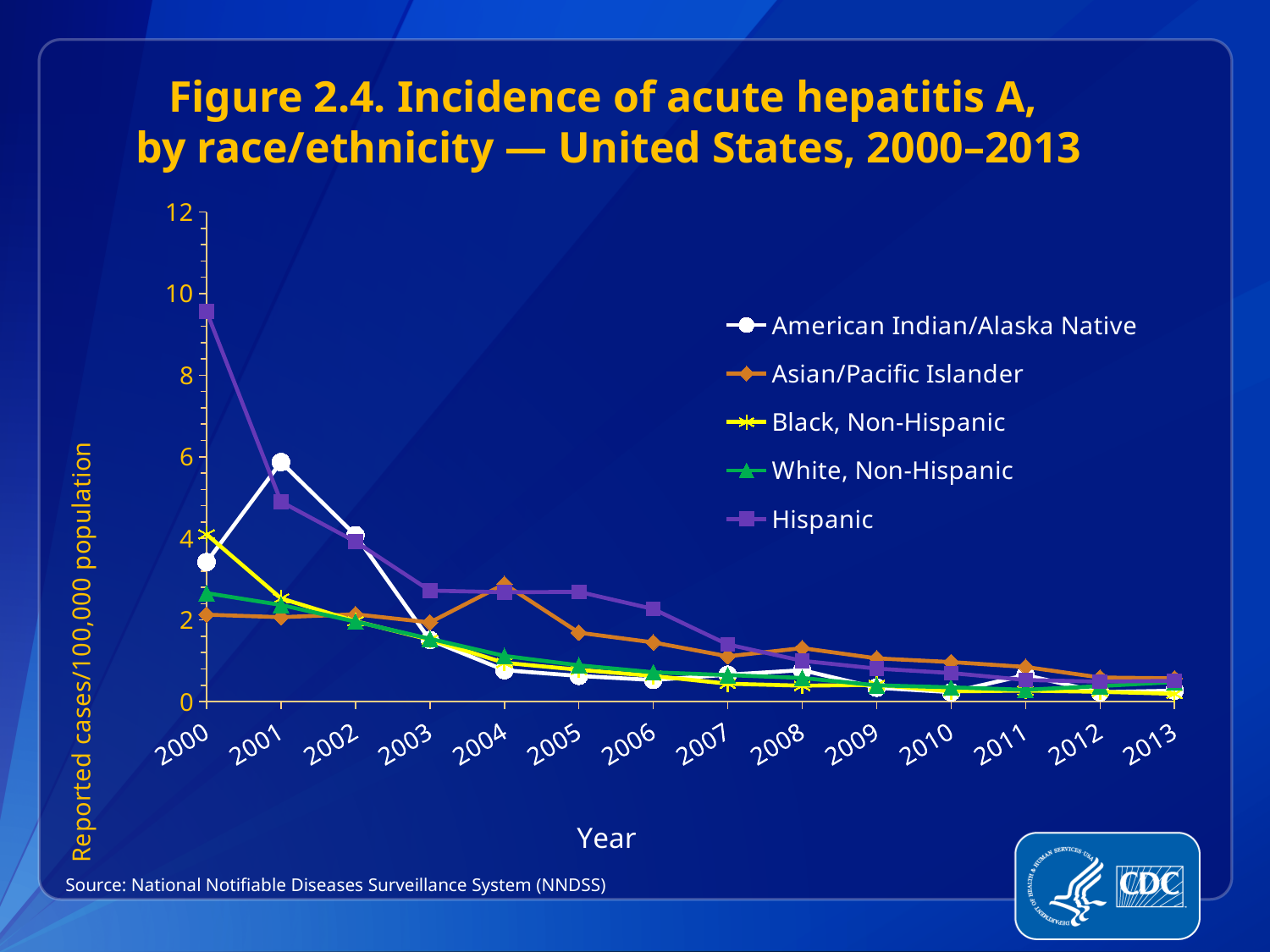
Which race/ethnicity group had the highest incidence in 2001? American Indian/Alaska Native How many series does the legend list? 5 What kind of chart is shown on the slide? line chart What is the source cited at the bottom of the slide? National Notifiable Diseases Surveillance System (NNDSS) What is the label of the y axis? Reported cases/100,000 population Is the value for Asian/Pacific Islander in 2005 greater or less than 2? less Which race/ethnicity group had the highest incidence in 2000? Hispanic Is the value for Hispanic in 2000 greater or less than 8? greater How many years are plotted along the x axis? 14 In 2001, which is larger: the value for American Indian/Alaska Native or the value for Hispanic? American Indian/Alaska Native Is the value for American Indian/Alaska Native in 2001 greater or less than 4? greater Does the Hispanic series rise or fall from 2000 to 2013? fall